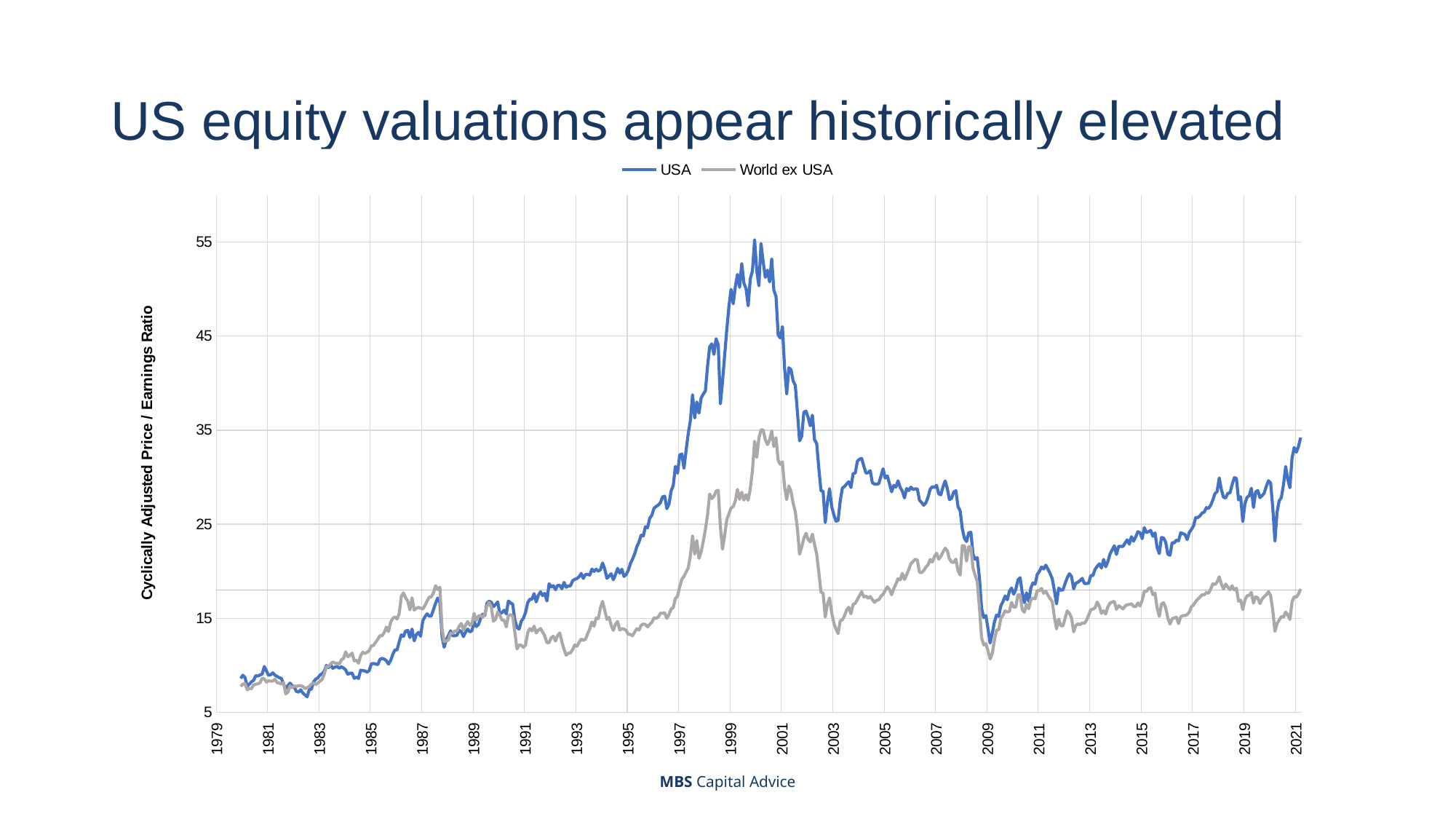
What kind of chart is shown on the slide? line chart Which series reaches the higher peak around the year 2000? USA Is the peak value of the USA series around 2000 greater or less than 45? greater Is the USA value at the end of the chart in 2021 greater or less than 25? greater What are the two series named in the legend? USA and World ex USA At the right end of the chart (2021), which series is higher, USA or World ex USA? USA Is the USA value at its low point around 2009 greater or less than 25? less What is the label on the vertical axis? Cyclically Adjusted Price / Earnings Ratio Does the USA series generally rise or fall between 2009 and 2021? rise How many series does the legend list? 2